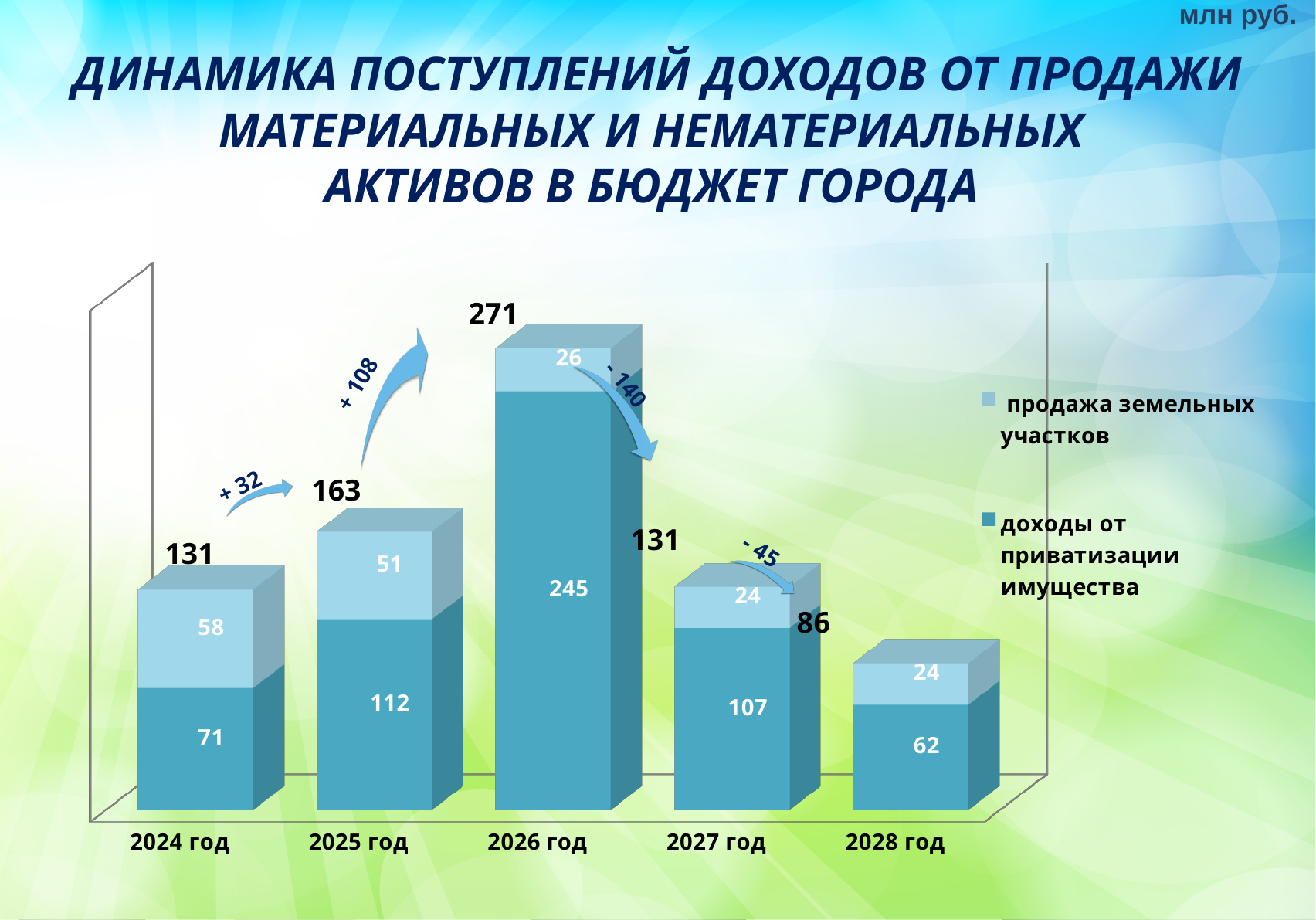
What kind of chart is shown on the slide? stacked bar chart Which year has the lowest total? 2028 год What is the total of the stacked bar for 2028 год? 86 How many series does the legend list? 2 What is the total labelled above the bar for 2027 год? 131 What unit is indicated in the top right corner of the slide? млн руб. What is the value for продажа земельных участков in 2025 год? 51 What is the value for доходы от приватизации имущества in 2026 год? 245 Which year has the highest total? 2026 год How many years (categories) are shown on the x axis? 5 What is the difference between the totals for 2026 год and 2025 год? 108 Which is larger: доходы от приватизации имущества in 2027 год or in 2028 год? 2027 год